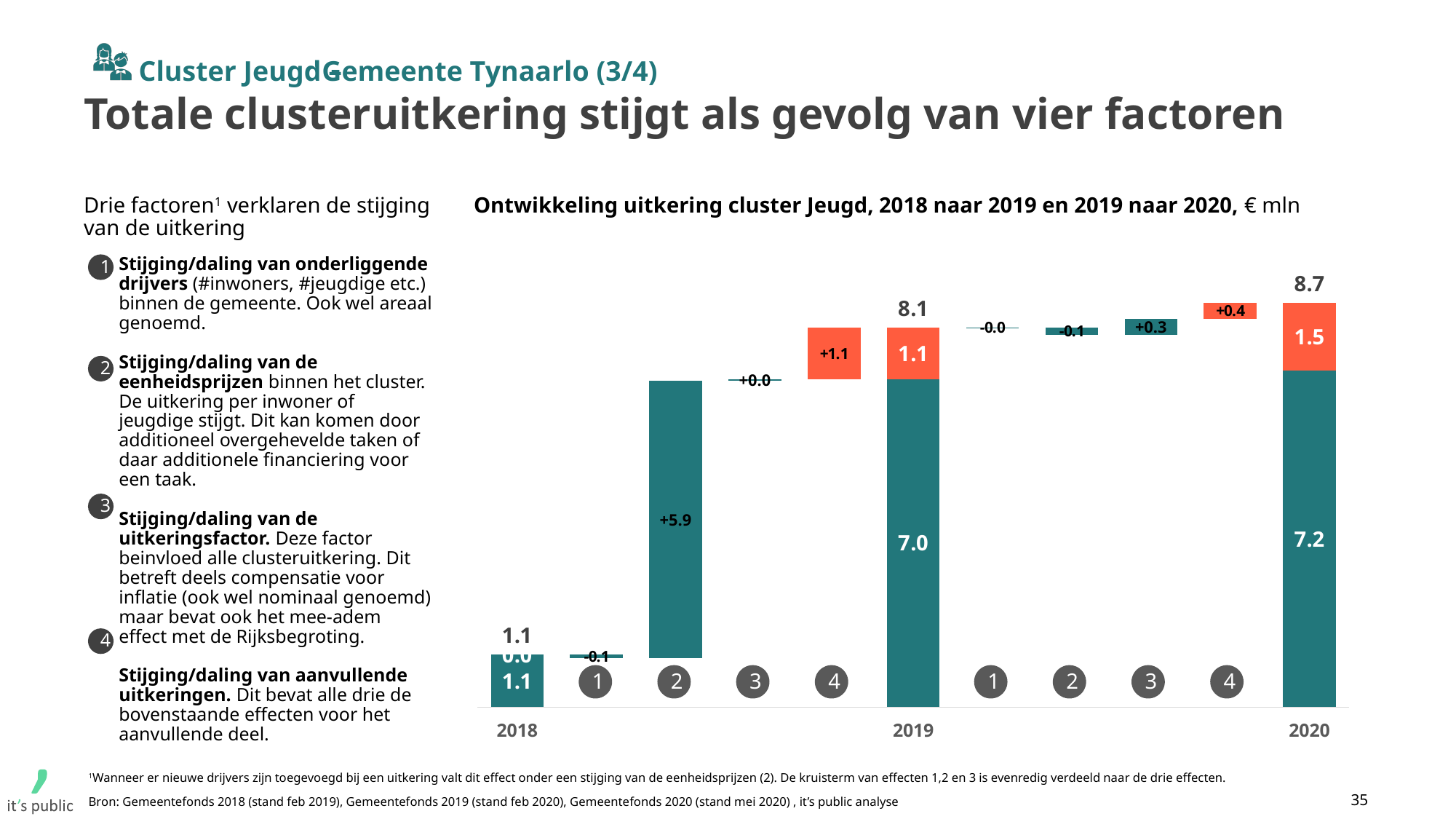
What is the total uitkering shown for 2019? 8.1 What is the value of factor 3 in the step from 2019 to 2020? +0.3 What is the value of factor 4 in the step from 2018 to 2019? +1.1 Which factor contributes more in the step from 2018 to 2019: factor 2 or factor 4? Factor 2 By how much does the total uitkering increase from 2019 to 2020? 0.6 What is the value of the teal (lower) segment of the 2020 bar? 7.2 What is the total uitkering shown for 2020? 8.7 What is the value of the orange (upper) segment of the 2019 bar? 1.1 Which year has the highest total uitkering? 2020 What is the total uitkering shown for 2018? 1.1 Does the total uitkering rise or fall from 2018 to 2020? Rise What is the value of factor 2 in the step from 2018 to 2019? +5.9